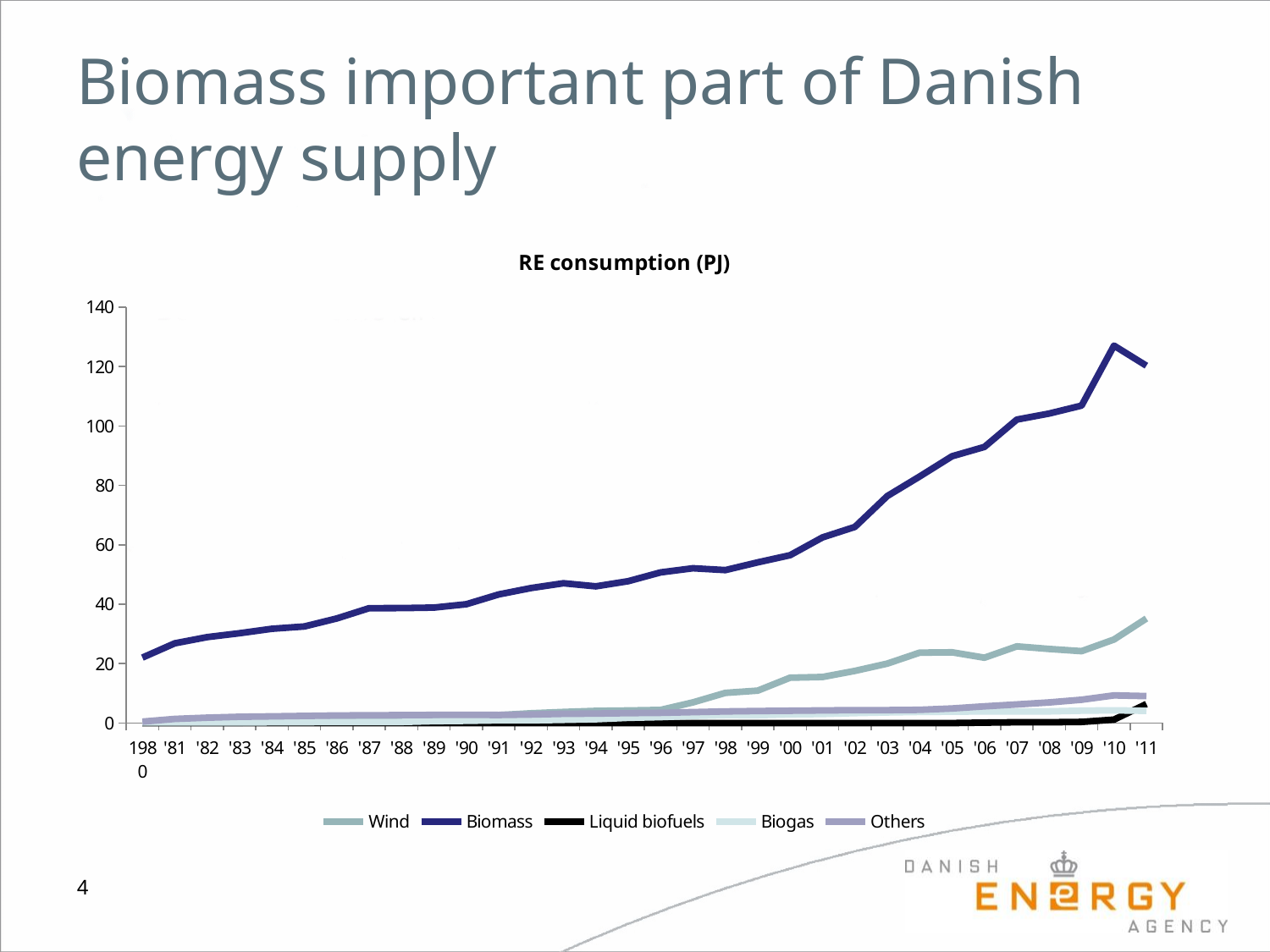
Is the value for Wind in '11 greater or less than 20? greater What is the title of the chart? RE consumption (PJ) Which series is drawn in black? Liquid biofuels What kind of chart is shown on the slide? Line chart Which series has the highest value in '11? Biomass Is the value for Biomass in '05 greater or less than 80? greater Is the value for Wind in '98 greater or less than 20? less How many series does the legend list? 5 Which is larger in '11, Biomass or Wind? Biomass Does the Biomass series generally rise or fall from 1980 to '11? Rise